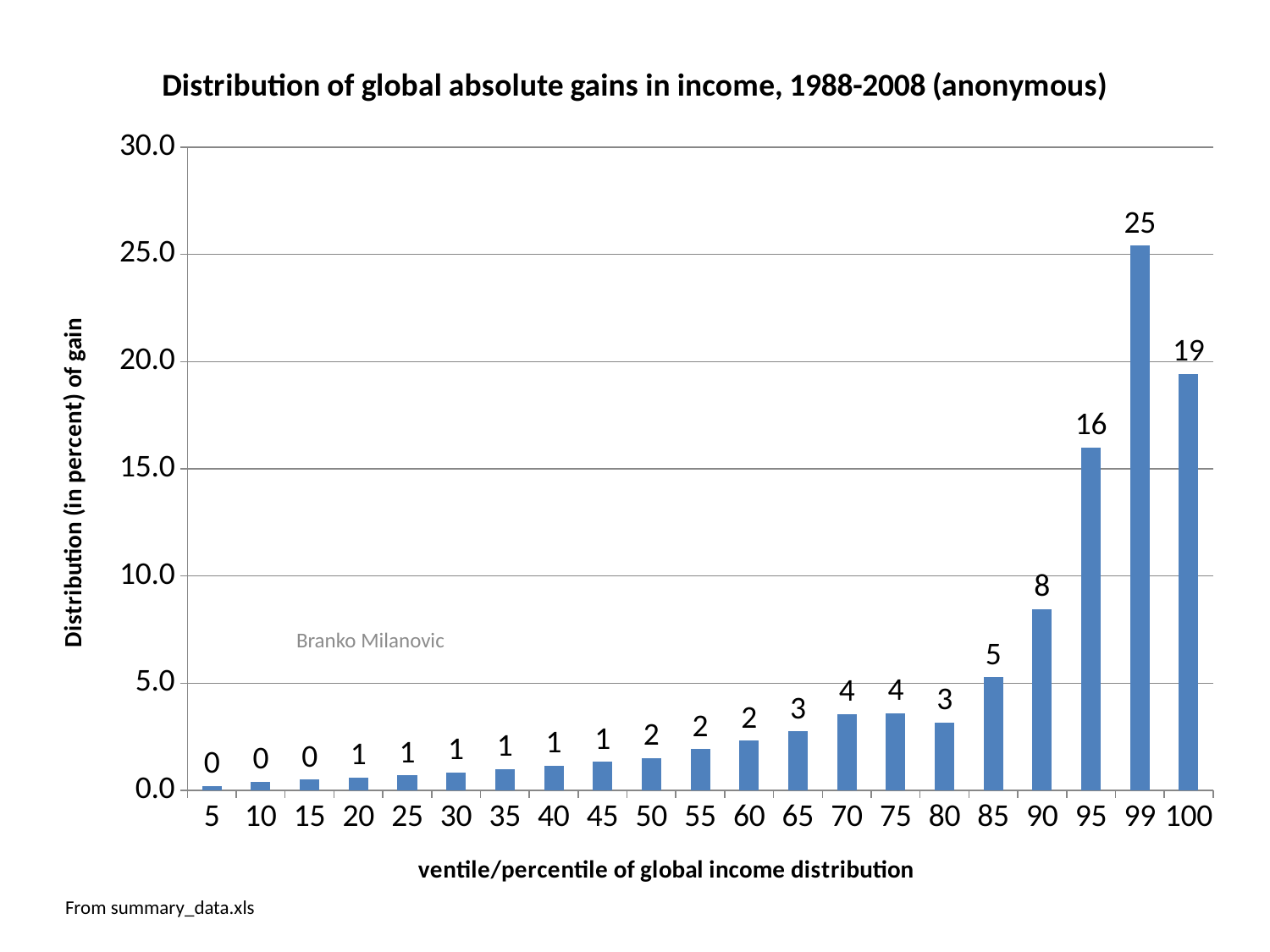
Do the values generally rise or fall as the percentile increases from 5 to 99? rise What kind of chart is shown on the slide? bar chart What is the value for the 95th percentile? 16 What is the title of the x axis? ventile/percentile of global income distribution What is the difference between the values for the 99th and 100th percentiles? 6 How many bars are shown in the chart? 21 Which percentile has the highest value? 99 What is the value for the 100th percentile? 19 What is the value for the 90th percentile? 8 Which has a larger value, the 95th percentile or the 100th percentile? 100 Is the value for the 99th percentile greater or less than 20.0? greater What is the value for the 99th percentile? 25